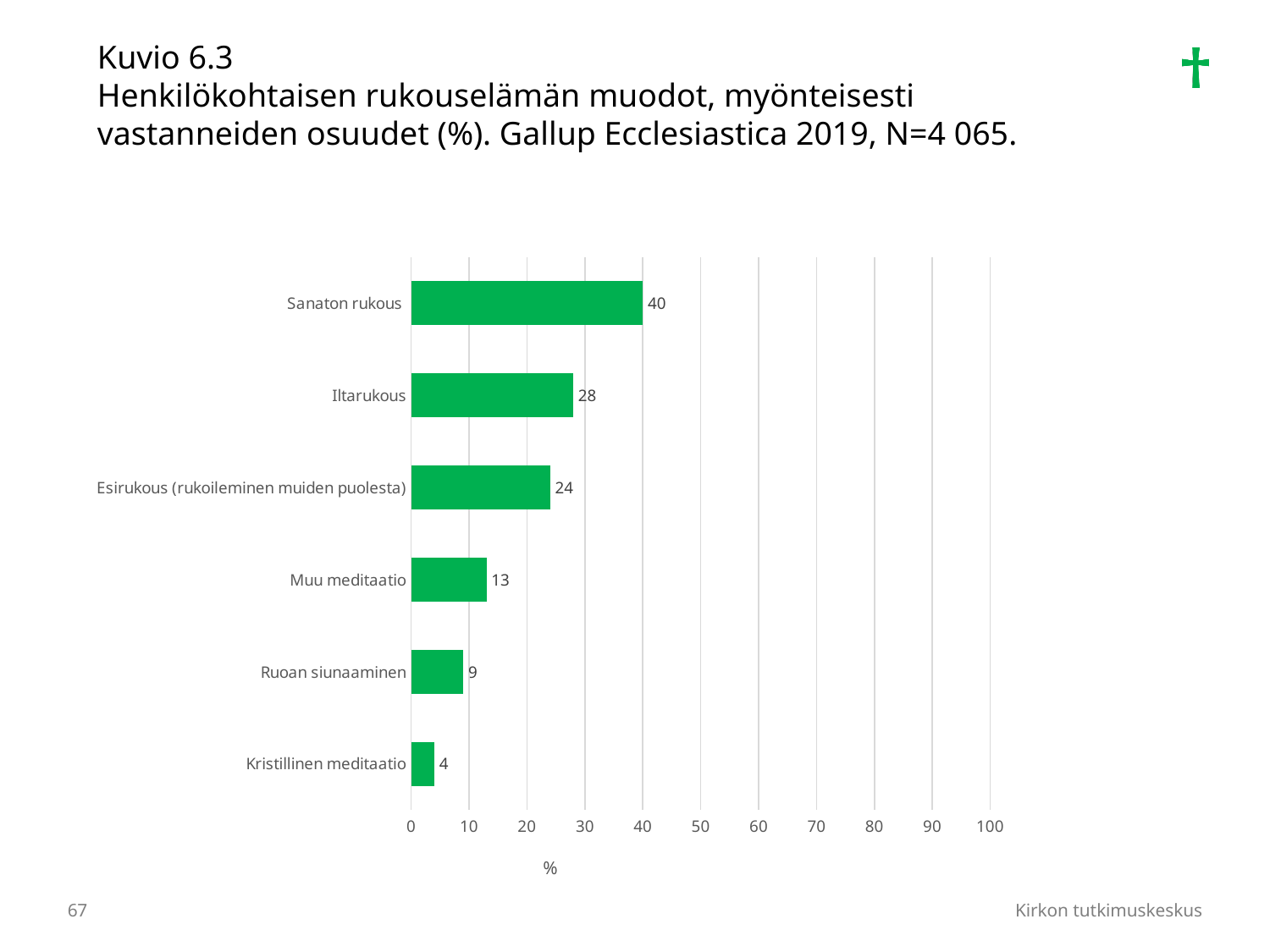
What is the value for Sanaton rukous? 40 Which category has the lowest value? Kristillinen meditaatio What is the label on the horizontal axis of the chart? % What kind of chart is shown on the slide? Bar chart What is the difference between the values for Muu meditaatio and Ruoan siunaaminen? 4 Which category has the highest value? Sanaton rukous How many categories are shown in the chart? 6 Which is larger, the value for Esirukous (rukoileminen muiden puolesta) or the value for Muu meditaatio? Esirukous (rukoileminen muiden puolesta) What is the value for Kristillinen meditaatio? 4 What is the value for Iltarukous? 28 What is the value for Esirukous (rukoileminen muiden puolesta)? 24 What is the difference between the values for Sanaton rukous and Iltarukous? 12